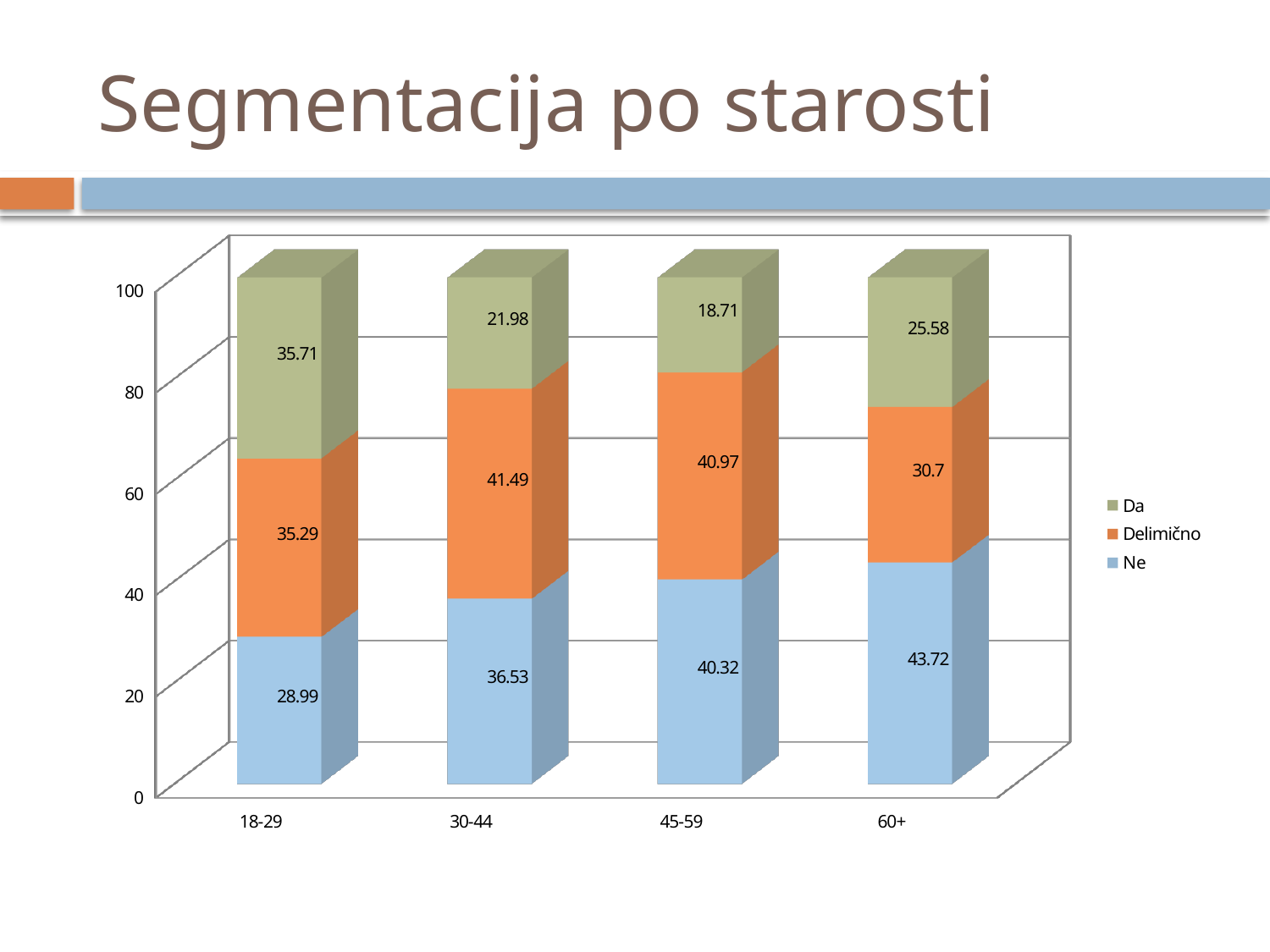
How many series does the legend list? 3 Which is larger: the Da value for 18-29 or the Da value for 60+? 18-29 What is the difference between the Ne values for the 60+ and 18-29 age groups? 14.73 What is the value of the Delimično series for the 30-44 age group? 41.49 Which age group has the highest value for the Ne series? 60+ What is the value of the Da series for the 45-59 age group? 18.71 Do the values of the Ne series rise or fall as the age groups increase along the x axis? Rise What kind of chart is shown on the slide? Stacked bar chart What is the total of the stacked bar for the 30-44 age group? 100 What is the value of the Ne series for the 60+ age group? 43.72 Which age group has the lowest value for the Da series? 45-59 How many age groups are shown on the x axis? 4